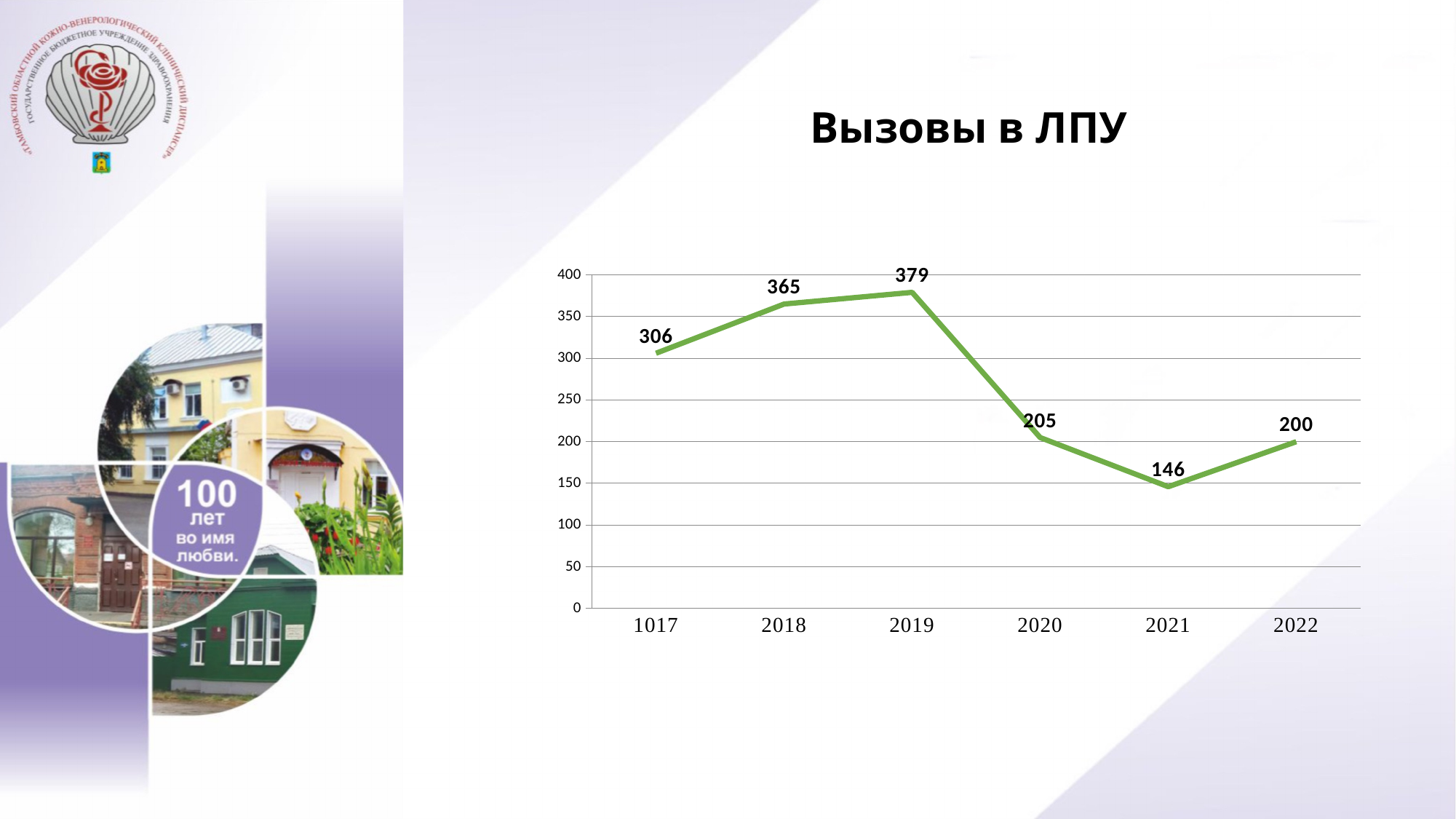
Which year has the highest value? 2019 What is the value for the first point, labelled 1017? 306 How many data points are plotted on the line? 6 Which year has the lowest value? 2021 What is the difference between the values for 2019 and 2020? 174 What is the difference between the values for 2018 and 2022? 165 What is the title of the chart? Вызовы в ЛПУ What is the value for 2021? 146 What is the value for 2019? 379 What kind of chart is shown on the slide? line chart Which is larger, the value for 2020 or the value for 2022? 2020 What is the value for 2022? 200